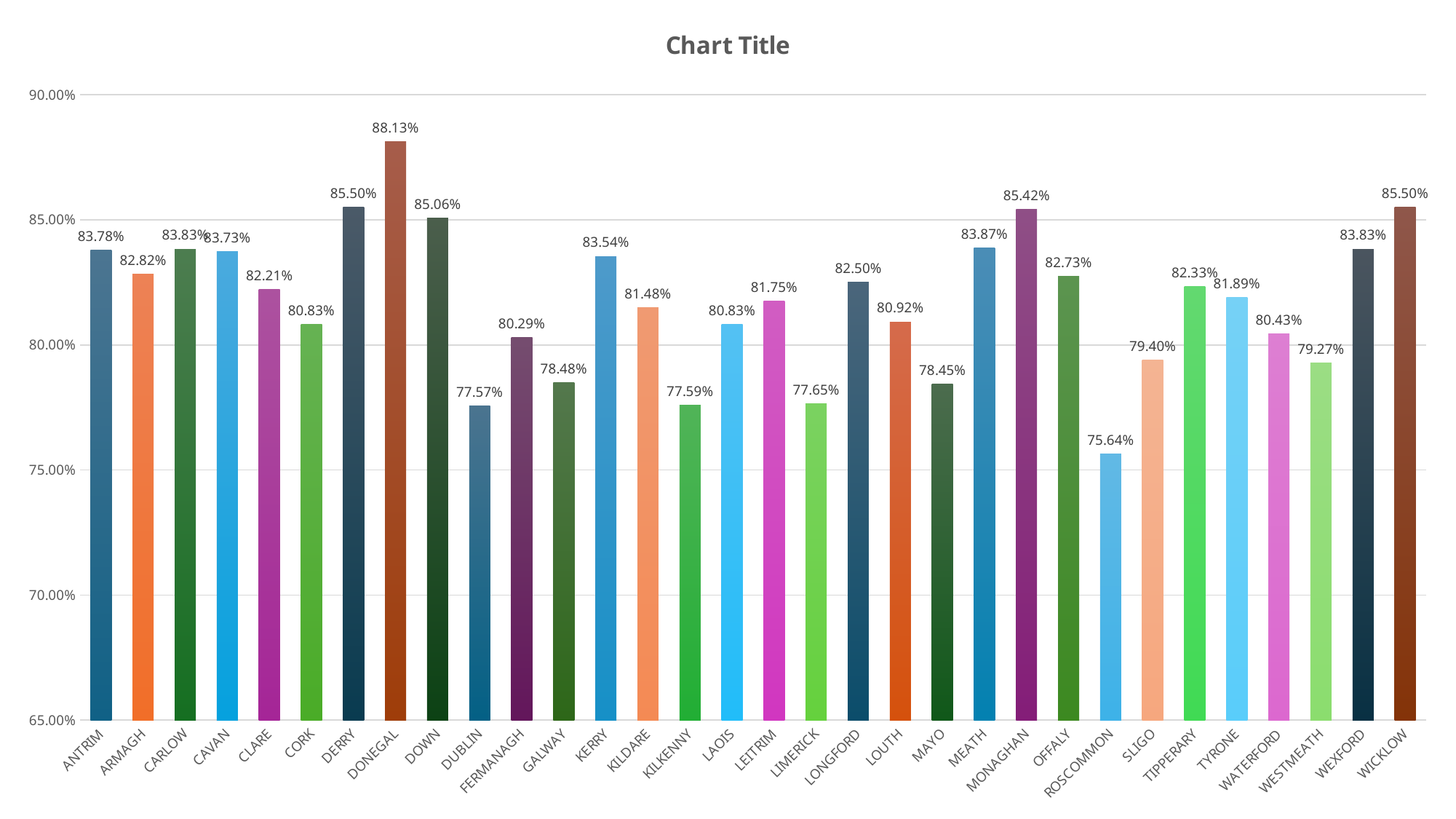
What is the value for Donegal? 88.13% What is the value for Roscommon? 75.64% Which county has the lowest value? Roscommon What is the difference between the values for Donegal and Roscommon? 12.49 percentage points How many counties are shown on the chart? 32 What is the difference between the values for Meath and Dublin? 6.30 percentage points What is the value for Meath? 83.87% What is the title of the chart? Chart Title What kind of chart is this? Bar chart Which is larger, the value for Kerry or the value for Kildare? Kerry Is the value for Sligo greater or less than 80.00%? less Which county has the highest value? Donegal